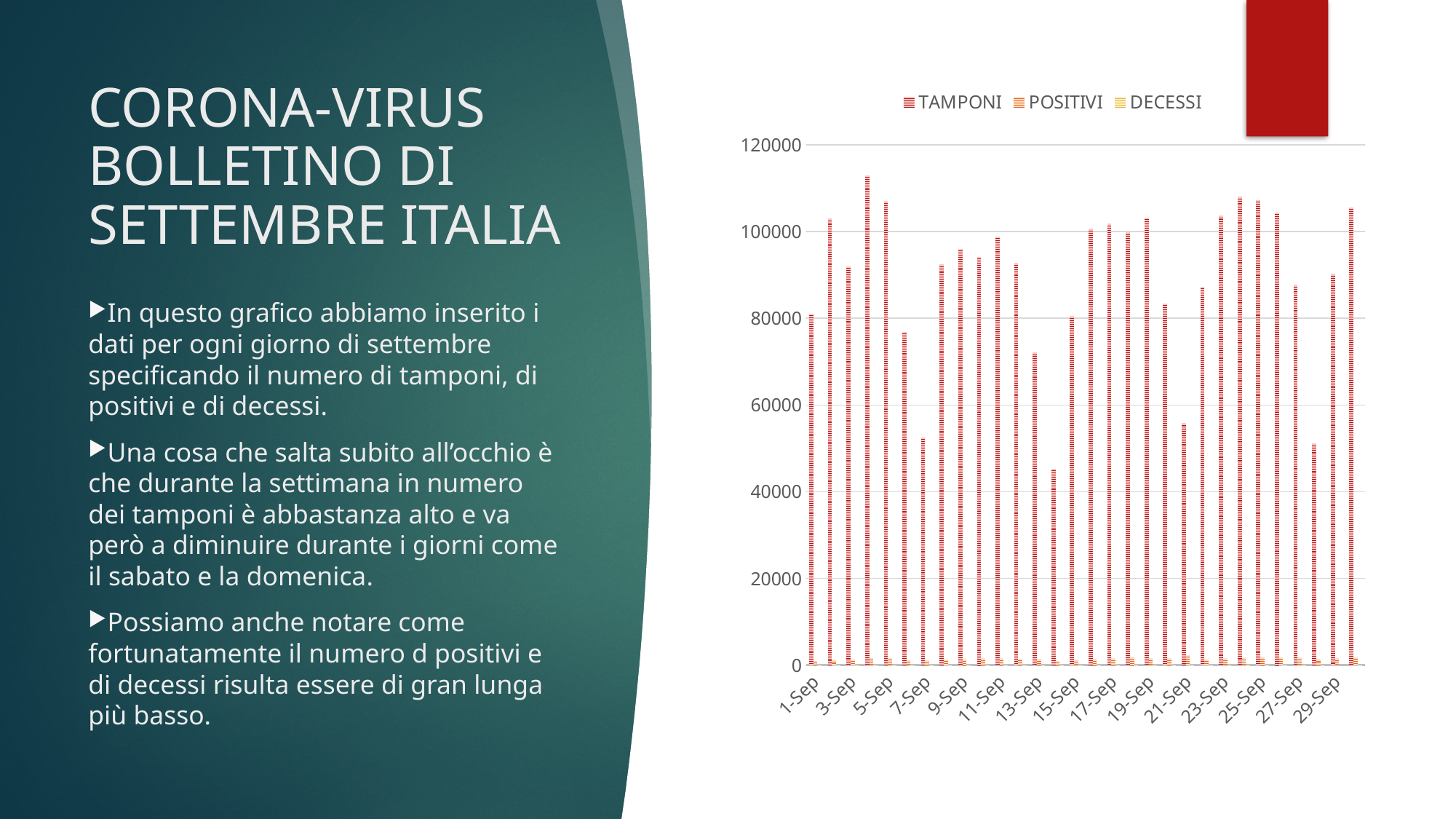
Which date has the larger TAMPONI value, 5-Sep or 7-Sep? 5-Sep Which series has the tallest bars in the chart? TAMPONI Is the TAMPONI value for 7-Sep greater or less than 60000? less What are the three series named in the chart legend? TAMPONI, POSITIVI, DECESSI How many date labels are shown along the x axis of the chart? 15 Is the TAMPONI value for 5-Sep greater or less than 100000? greater What kind of chart is shown on the slide? bar chart Is the TAMPONI value for 25-Sep greater or less than 100000? greater How many series does the chart legend list? 3 What is the highest value shown on the chart's vertical axis? 120000